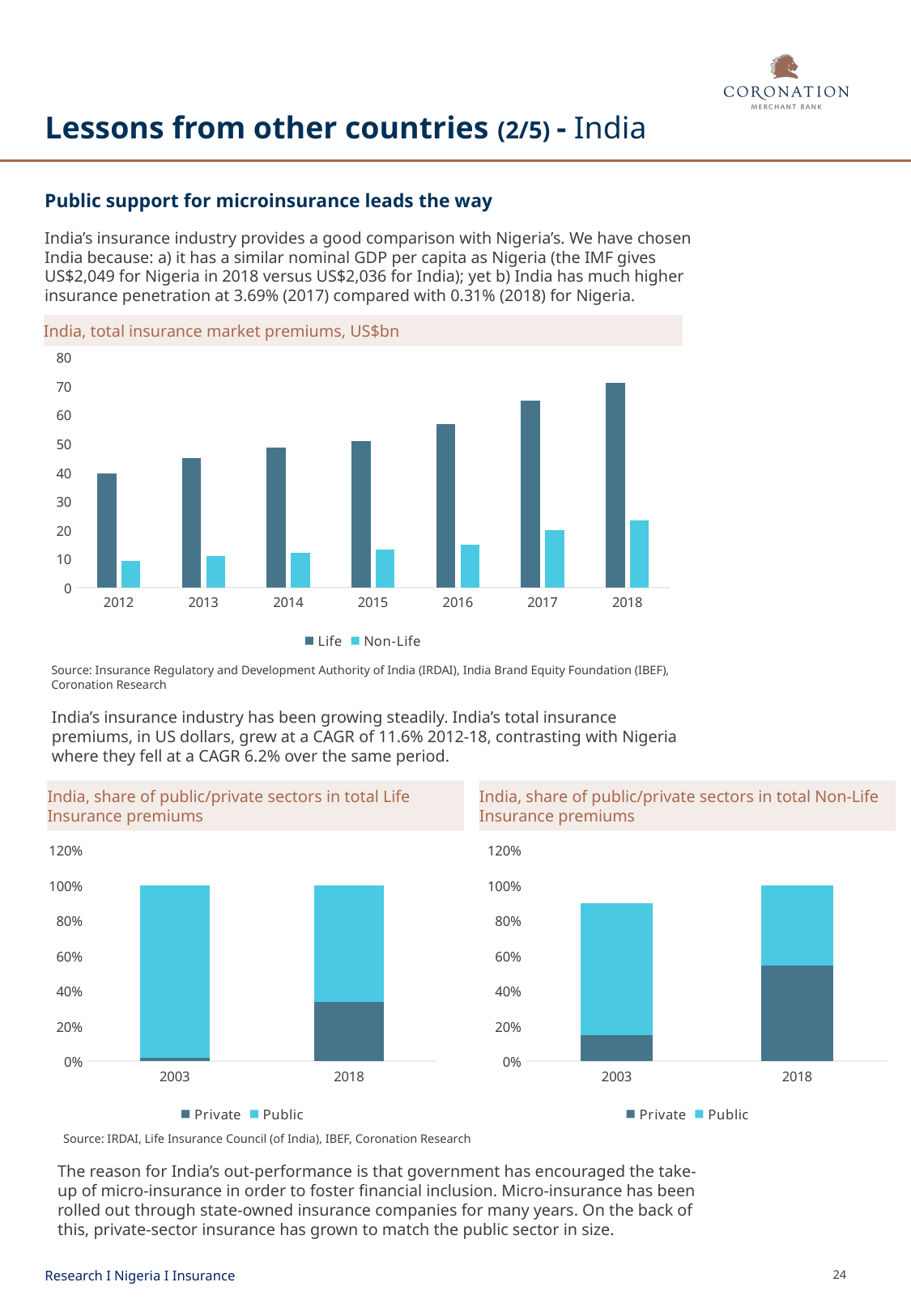
In the chart 'India, total insurance market premiums, US$bn', do Life premiums rise or fall from 2012 to 2018? Rise In the chart 'India, share of public/private sectors in total Life Insurance premiums', which year has the larger Private share, 2003 or 2018? 2018 In the chart 'India, total insurance market premiums, US$bn', is the Life value for 2018 greater or less than 60? greater In the chart 'India, total insurance market premiums, US$bn', which is larger in 2015, Life or Non-Life? Life In the chart 'India, total insurance market premiums, US$bn', what kind of chart is shown? Bar chart In the chart 'India, total insurance market premiums, US$bn', which year has the lowest Non-Life premiums? 2012 In the chart 'India, total insurance market premiums, US$bn', which year has the highest Life premiums? 2018 In the chart 'India, total insurance market premiums, US$bn', is the Non-Life value for 2018 greater or less than 30? less In the chart 'India, total insurance market premiums, US$bn', how many series does the legend list? 2 In the chart 'India, share of public/private sectors in total Non-Life Insurance premiums', is the Private share for 2018 greater or less than 40%? greater In the chart 'India, share of public/private sectors in total Life Insurance premiums', what entries does the legend list? Private, Public In the chart 'India, total insurance market premiums, US$bn', how many years are shown on the x axis? 7